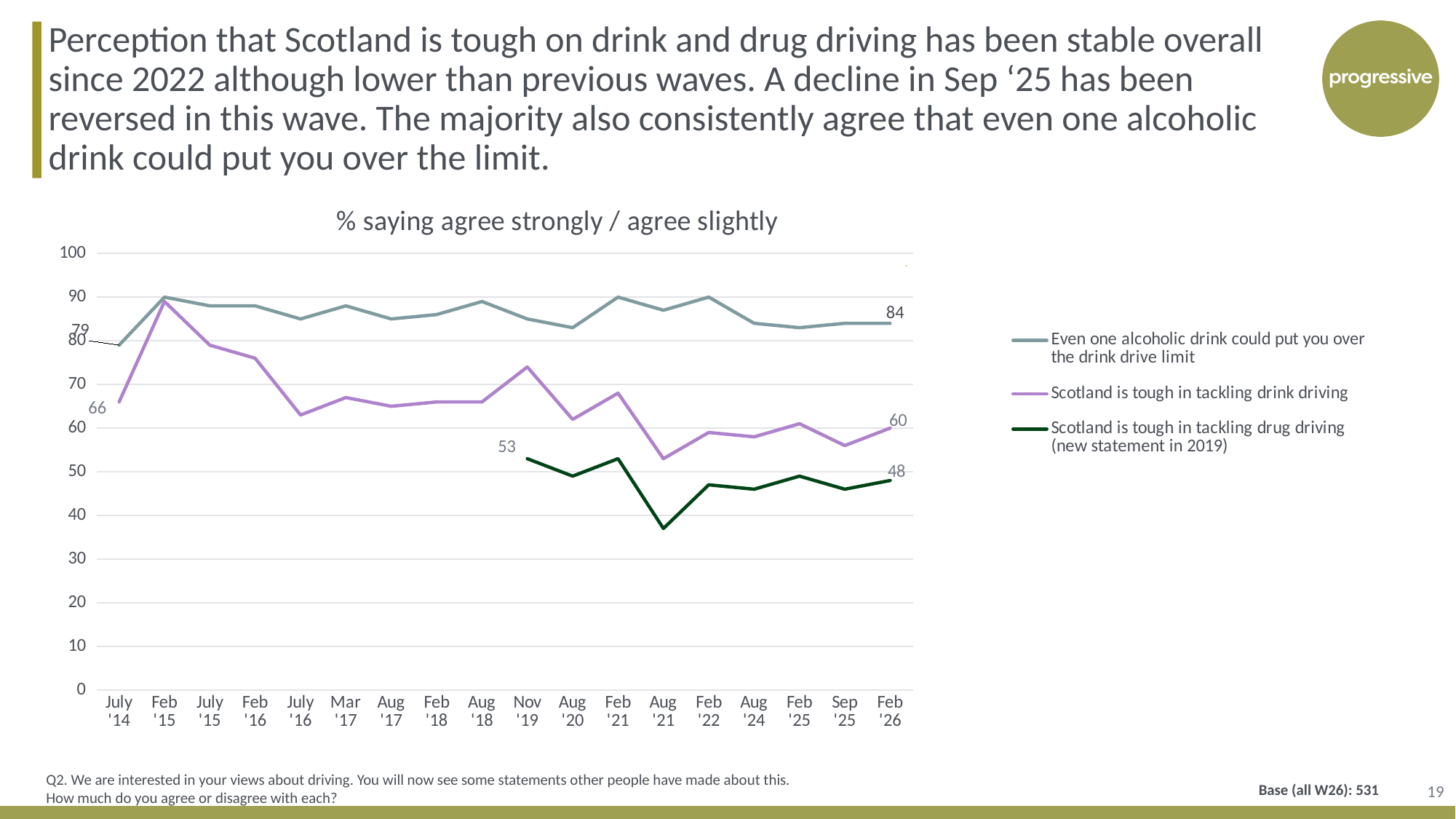
Which series has the lowest value in Feb '26? Scotland is tough in tackling drug driving What is the difference between the Feb '26 values for 'Scotland is tough in tackling drink driving' and 'Scotland is tough in tackling drug driving'? 12 How many time points are shown on the x axis? 18 What is the value for 'Scotland is tough in tackling drug driving' in Nov '19? 53 What is the difference between the Feb '26 values for 'Even one alcoholic drink could put you over the drink drive limit' and 'Scotland is tough in tackling drink driving'? 24 Is the value for 'Scotland is tough in tackling drug driving' in Aug '21 greater or less than 40? less What kind of chart is shown on the slide? Line chart What is the value for 'Scotland is tough in tackling drink driving' in July '14? 66 How many series does the legend list? 3 In Feb '26, which is larger: 'Scotland is tough in tackling drink driving' or 'Scotland is tough in tackling drug driving'? Scotland is tough in tackling drink driving What is the value for 'Scotland is tough in tackling drink driving' in Feb '26? 60 What is the value for 'Even one alcoholic drink could put you over the drink drive limit' in Feb '26? 84